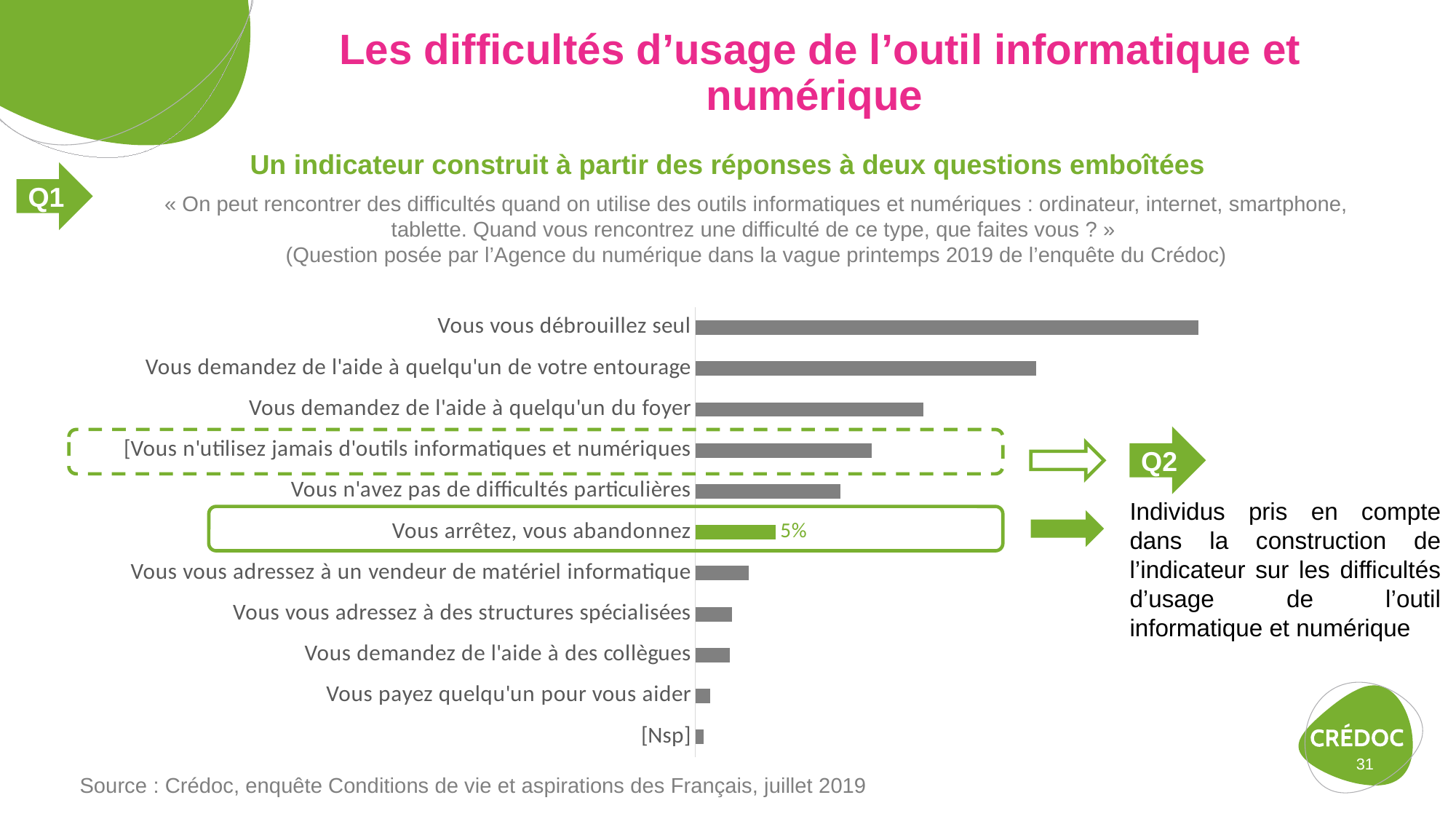
Which is larger: the bar for "Vous demandez de l'aide à quelqu'un de votre entourage" or the bar for "Vous demandez de l'aide à quelqu'un du foyer"? Vous demandez de l'aide à quelqu'un de votre entourage How many categories are plotted in the bar chart? 11 Which category is the second longest bar in the chart? Vous demandez de l'aide à quelqu'un de votre entourage Which is larger: the bar for "Vous n'avez pas de difficultés particulières" or the bar for "Vous vous adressez à un vendeur de matériel informatique"? Vous n'avez pas de difficultés particulières What kind of chart is shown on the slide? bar chart Which category has the shortest bar in the chart? [Nsp] Which category has the longest bar in the chart? Vous vous débrouillez seul Which is larger: the bar for "[Vous n'utilisez jamais d'outils informatiques et numériques" or the bar for "Vous n'avez pas de difficultés particulières"? [Vous n'utilisez jamais d'outils informatiques et numériques Which category is the only one with a data label printed next to its bar? Vous arrêtez, vous abandonnez What value is shown for "Vous arrêtez, vous abandonnez"? 5% Which bar in the chart is coloured green rather than grey? Vous arrêtez, vous abandonnez